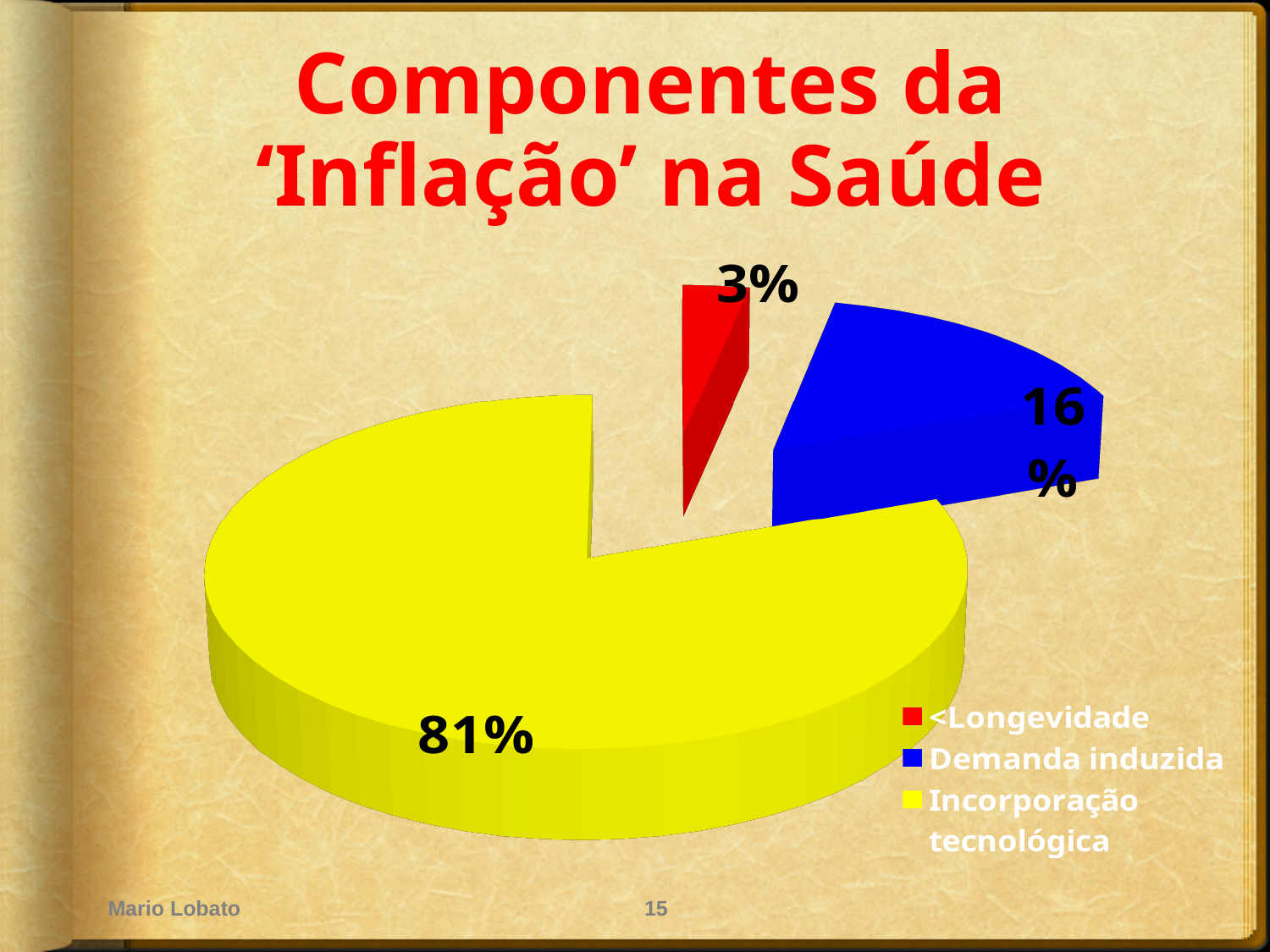
Which category has the smallest slice of the pie? <Longevidade What share of the pie does <Longevidade have? 3% Which is larger, the slice for Demanda induzida or the slice for <Longevidade? Demanda induzida What is the difference in percentage points between Demanda induzida and <Longevidade? 13 How many entries does the legend list? 3 How many slices does the pie chart have? 3 What colour is the slice for Demanda induzida? Blue What share of the pie does Incorporação tecnológica have? 81% Which category has the largest slice of the pie? Incorporação tecnológica What is the difference in percentage points between Incorporação tecnológica and Demanda induzida? 65 What share of the pie does Demanda induzida have? 16% What kind of chart is shown on the slide? Pie chart